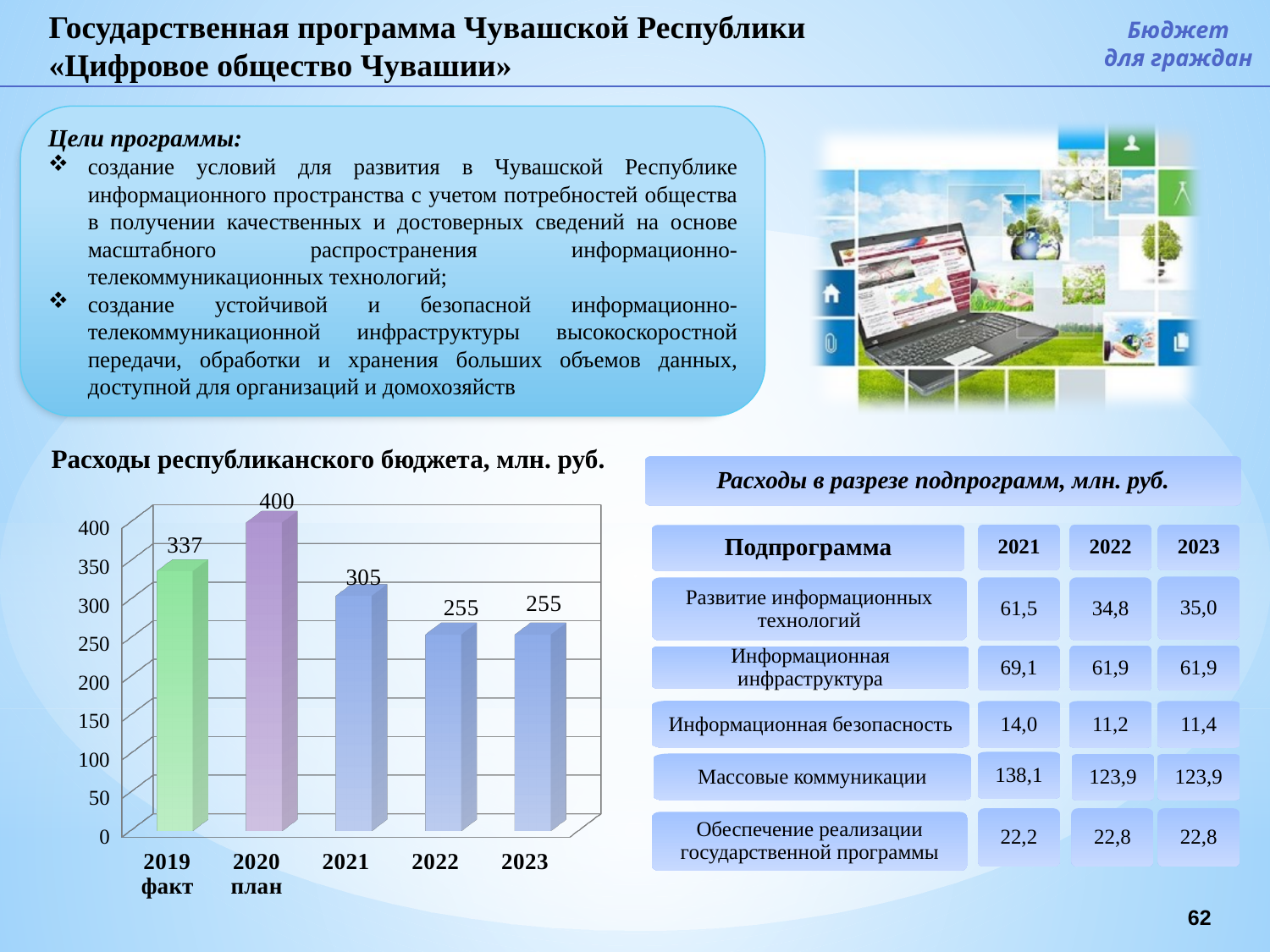
What is the difference between the values for 2020 план and 2021? 95 What is the value for 2021 in the chart? 305 Which year has the highest value in the chart? 2020 план How many bars are shown in the chart? 5 What is the difference between the values for 2019 факт and 2022? 82 What kind of chart is shown on the slide? bar chart Do the values rise or fall from 2020 план to 2022? fall What is the value for 2019 факт in the chart 'Расходы республиканского бюджета, млн. руб.'? 337 Is the value for 2021 greater or less than 350? less What is the value for 2023 in the chart? 255 Which is larger, the value for 2019 факт or the value for 2021? 2019 факт What is the value for 2020 план in the chart? 400